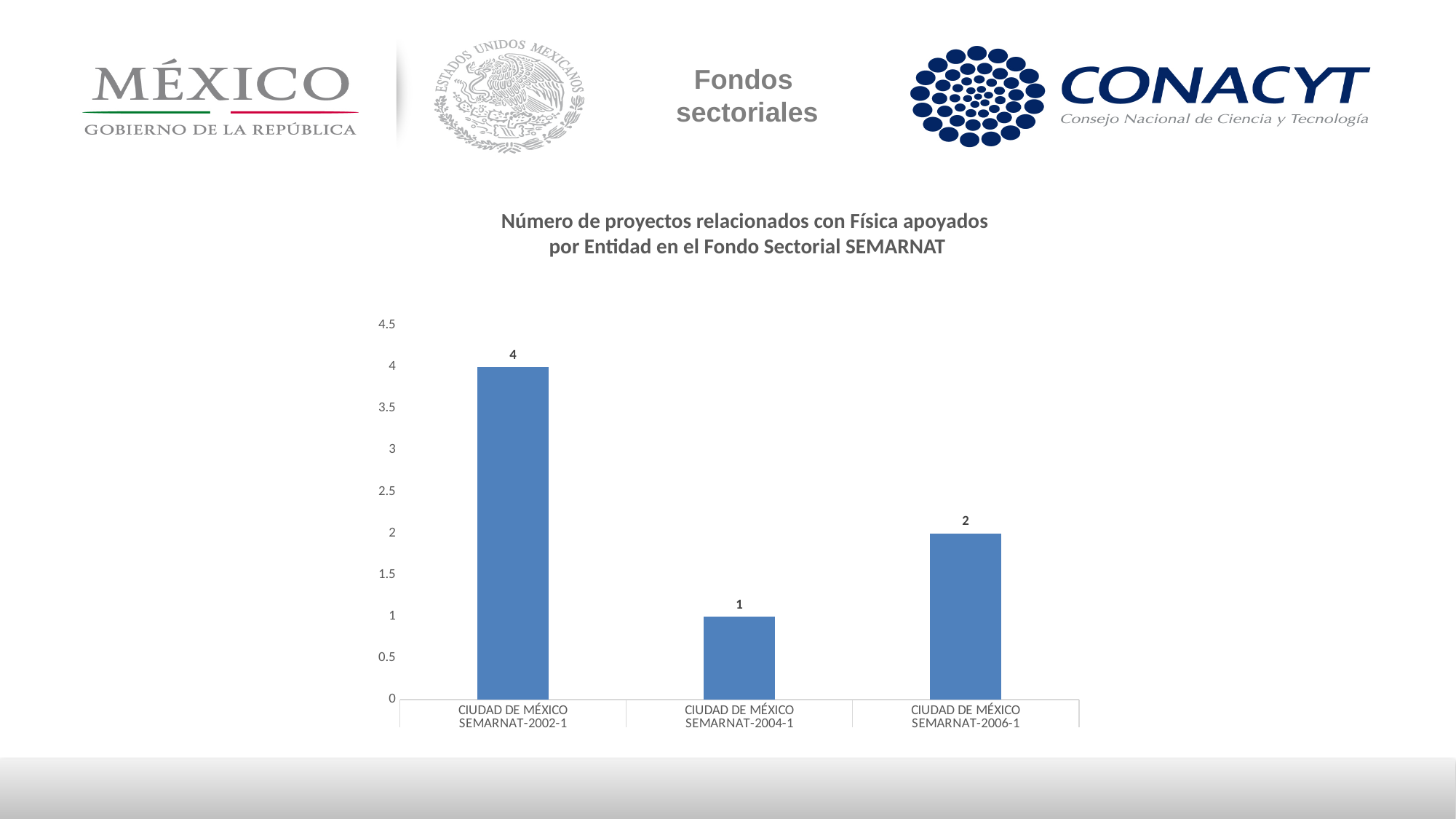
What is the difference between the values for SEMARNAT-2006-1 and SEMARNAT-2004-1? 1 How many categories are shown on the x axis? 3 Is the value for CIUDAD DE MÉXICO SEMARNAT-2002-1 greater or less than 3? greater Which category has the lowest value? CIUDAD DE MÉXICO SEMARNAT-2004-1 What is the value for CIUDAD DE MÉXICO SEMARNAT-2002-1? 4 Which category has the highest value? CIUDAD DE MÉXICO SEMARNAT-2002-1 What is the title of the chart? Número de proyectos relacionados con Física apoyados por Entidad en el Fondo Sectorial SEMARNAT What kind of chart is shown on the slide? bar chart What is the value for CIUDAD DE MÉXICO SEMARNAT-2006-1? 2 What is the value for CIUDAD DE MÉXICO SEMARNAT-2004-1? 1 What is the difference between the values for SEMARNAT-2002-1 and SEMARNAT-2006-1? 2 Which is larger, the value for SEMARNAT-2004-1 or SEMARNAT-2006-1? SEMARNAT-2006-1